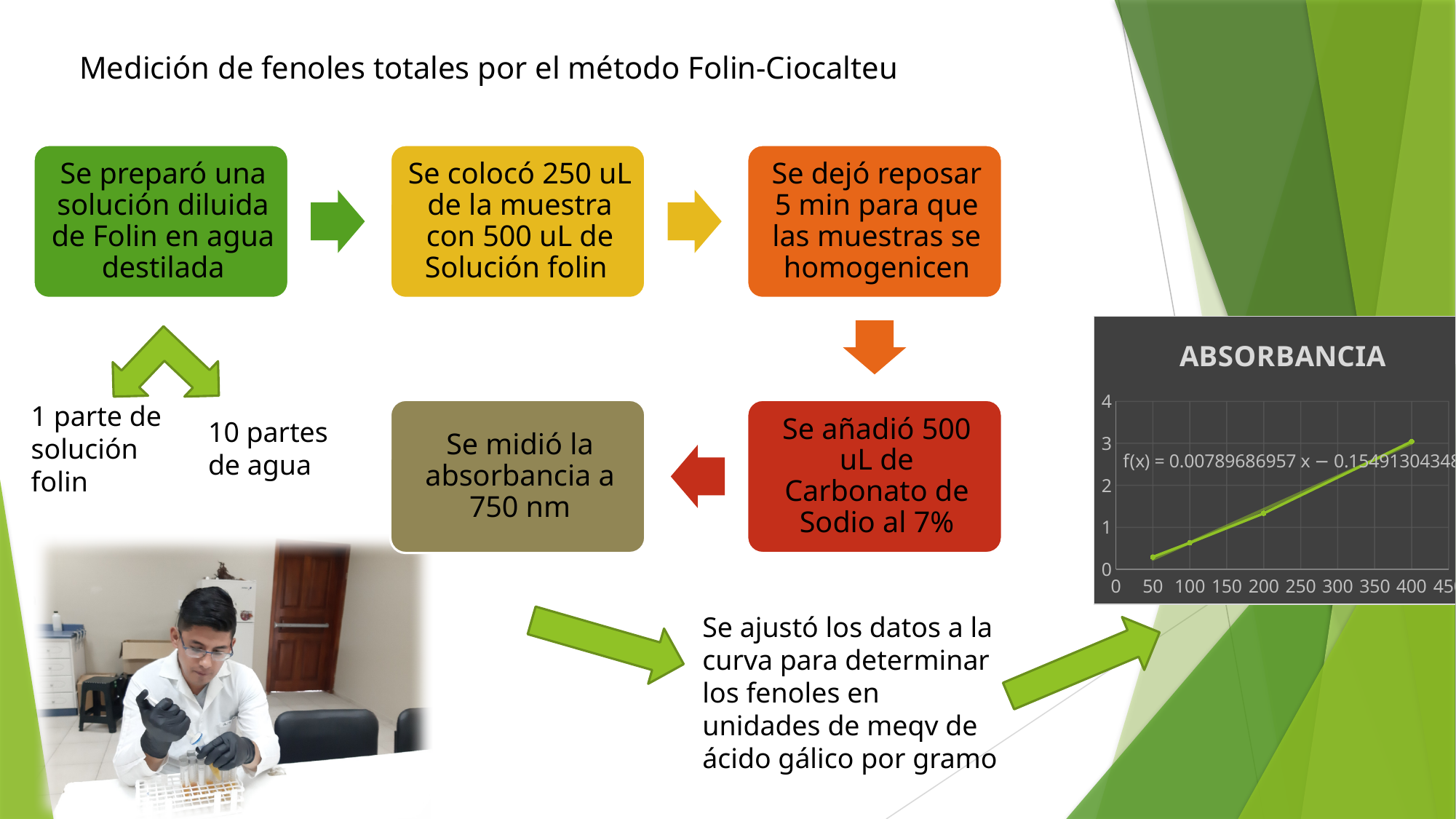
In the ABSORBANCIA chart, is the value at x = 200 greater or less than 1? greater In the ABSORBANCIA chart, is the value at x = 400 greater or less than 2? greater What is the title of the chart on the right of the slide? ABSORBANCIA How many data points are plotted in the ABSORBANCIA chart? 4 What kind of chart is shown under the title ABSORBANCIA? line chart What is the slope shown in the trendline equation on the ABSORBANCIA chart? 0.00789686957 In the ABSORBANCIA chart, at which x value is the plotted absorbance lowest? 50 In the ABSORBANCIA chart, at which x value is the plotted absorbance highest? 400 In the ABSORBANCIA chart, is the value at x = 50 greater or less than 1? less In the ABSORBANCIA chart, which has the larger absorbance, the point at x = 200 or the point at x = 100? x = 200 In the ABSORBANCIA chart, do the values rise or fall as x increases? rise